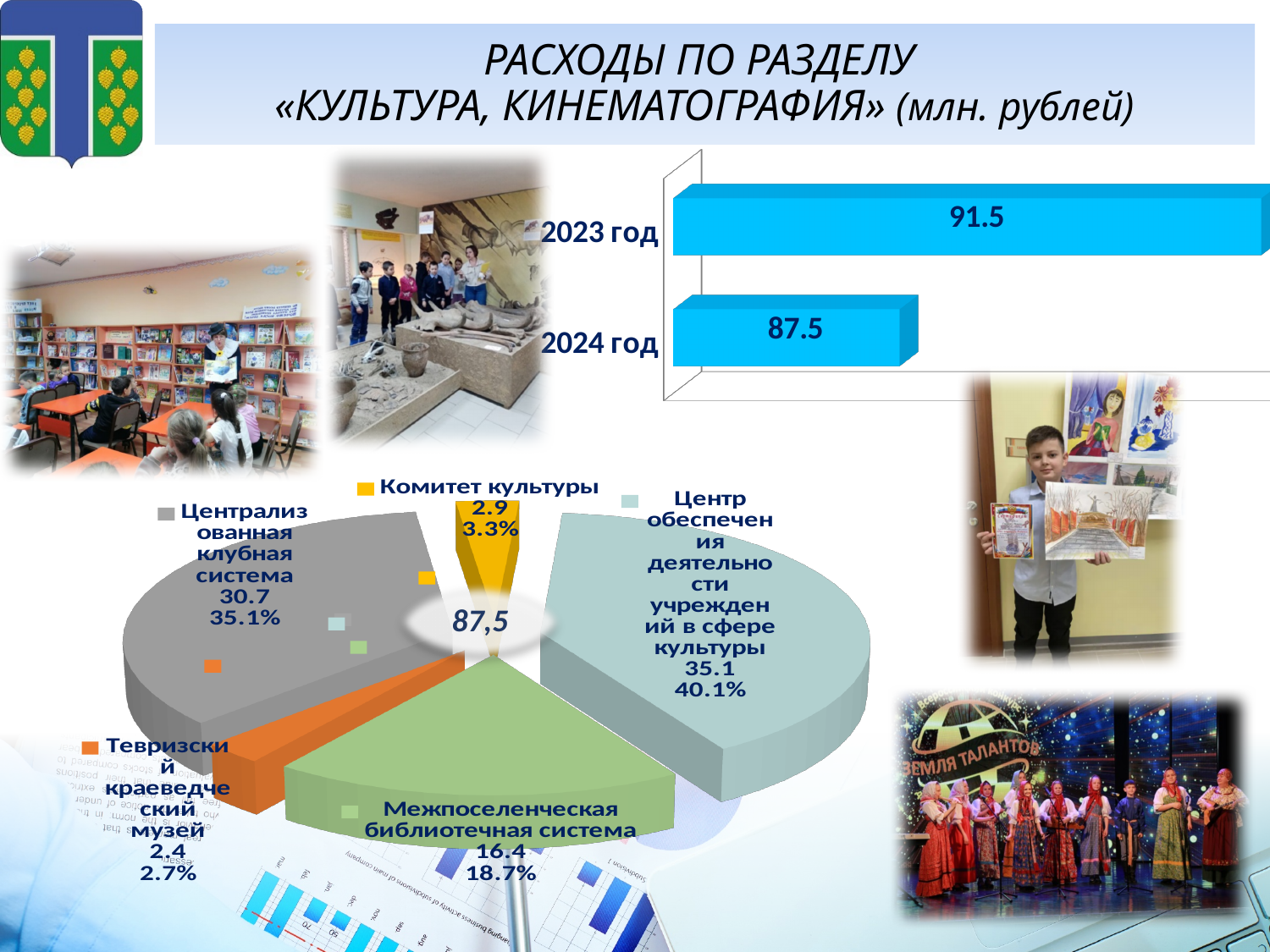
In the bar chart, what is the difference between the values for 2023 год and 2024 год? 4.0 How many slices does the pie chart have? 5 In the pie chart, what is the value for Межпоселенческая библиотечная система? 16.4 In the pie chart, what is the difference between the values for Централизованная клубная система and Межпоселенческая библиотечная система? 14.3 What kind of chart is the chart at the top right of the slide? bar chart In the bar chart, which year has the higher value, 2023 год or 2024 год? 2023 год In the bar chart, what is the value for 2024 год? 87.5 What number is shown in the centre of the pie chart? 87,5 In the pie chart, which category has the smallest slice? Тевризский краеведческий музей In the pie chart, what share does Централизованная клубная система have? 35.1% In the pie chart, which category has the largest slice? Центр обеспечения деятельности учреждений в сфере культуры In the bar chart, what is the value for 2023 год? 91.5